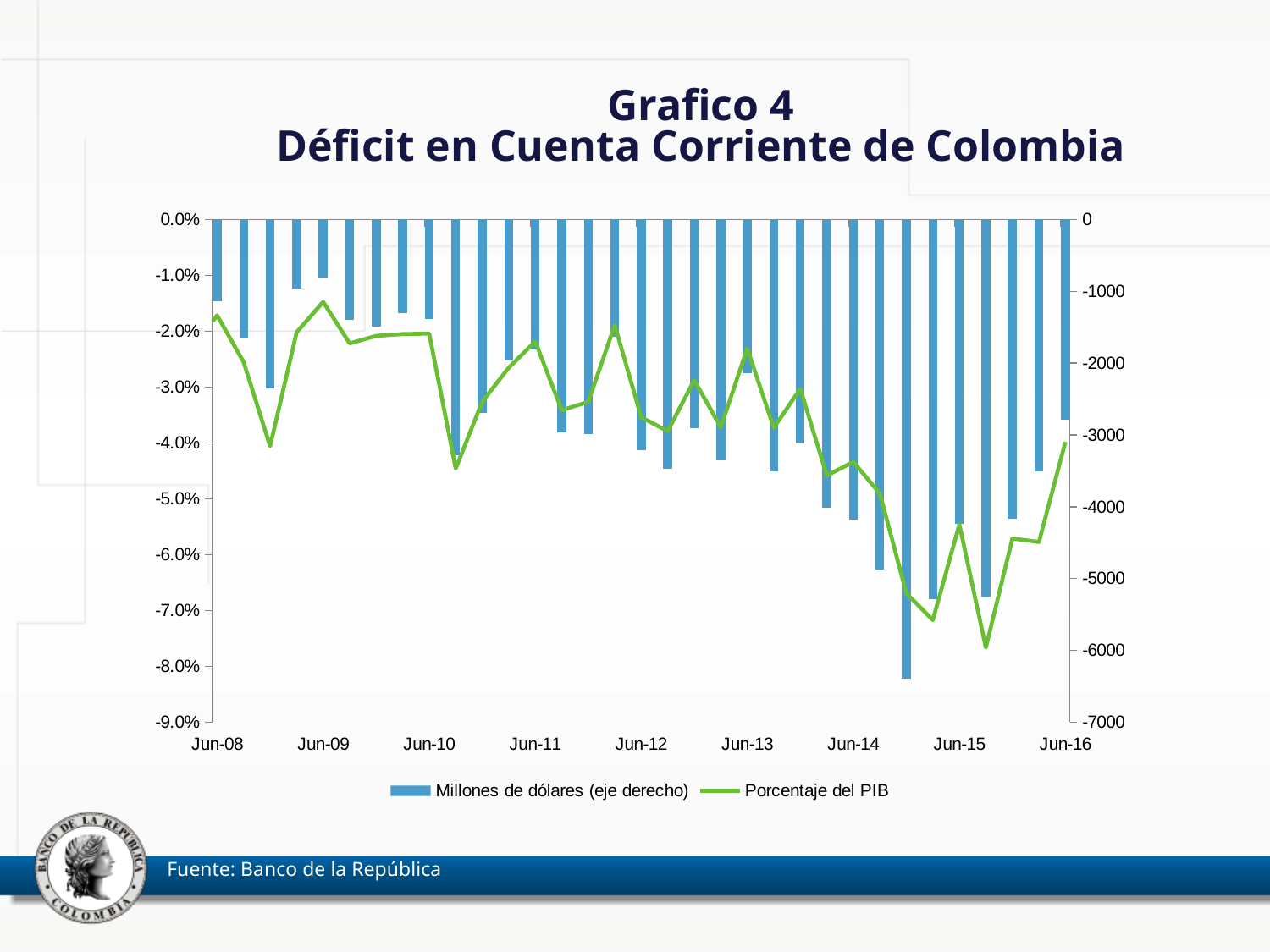
How many series does the legend list? 2 How many date labels are shown on the x axis? 9 Is the Porcentaje del PIB value at Jun-08 greater or less than -2.0%? greater Which series is plotted as bars? Millones de dólares (eje derecho) Is the Porcentaje del PIB value at Jun-14 greater or less than -4.0%? less Does the Porcentaje del PIB line rise or fall between Jun-13 and Jun-15? fall What kind of chart is this? Combination bar and line chart Which is higher (less negative), the Porcentaje del PIB at Jun-08 or at Jun-14? Jun-08 Is the Millones de dólares bar at Jun-14 greater or less than -3000? less What is the title of the chart? Grafico 4 Déficit en Cuenta Corriente de Colombia